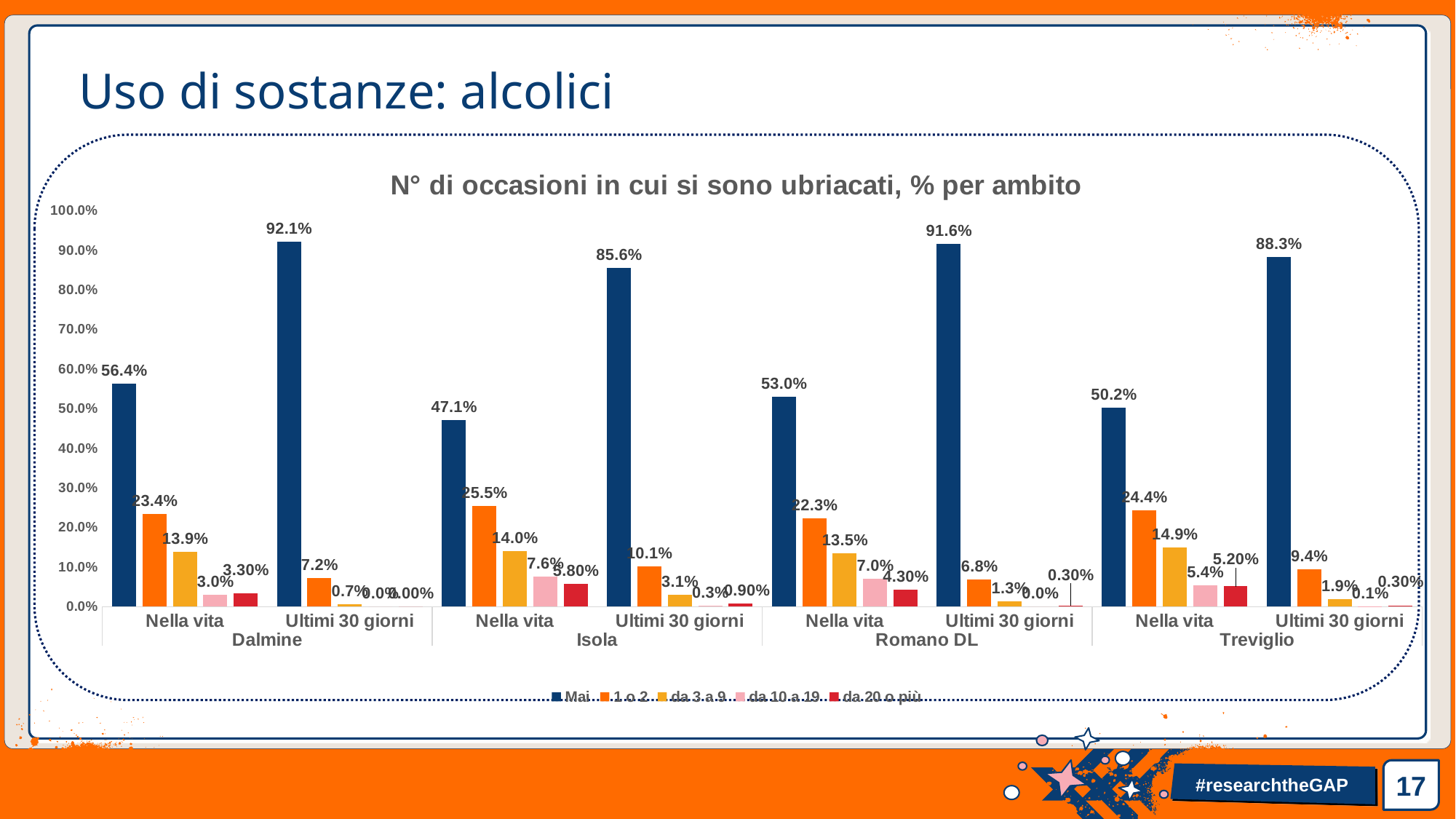
What is the value of the "da 10 a 19" series for "Nella vita" in Romano DL? 7.0% Which area has the highest "Mai" value for "Ultimi 30 giorni"? Dalmine How many series does the legend list? 5 What is the value of the "1 o 2" series for "Nella vita" in Isola? 25.5% What is the difference between the "Mai" values for "Ultimi 30 giorni" and "Nella vita" in Treviglio? 38.1% What kind of chart is shown on the slide? Bar chart Which is larger: the "1 o 2" value for "Nella vita" in Dalmine or in Treviglio? Treviglio What is the value of the "da 3 a 9" series for "Nella vita" in Treviglio? 14.9% Which area has the lowest "Mai" value for "Nella vita"? Isola What is the title of the chart? N° di occasioni in cui si sono ubriacati, % per ambito Is the "Mai" value for "Nella vita" in Romano DL greater or less than 50.0%? greater What is the value of the "Mai" series for "Ultimi 30 giorni" in Dalmine? 92.1%